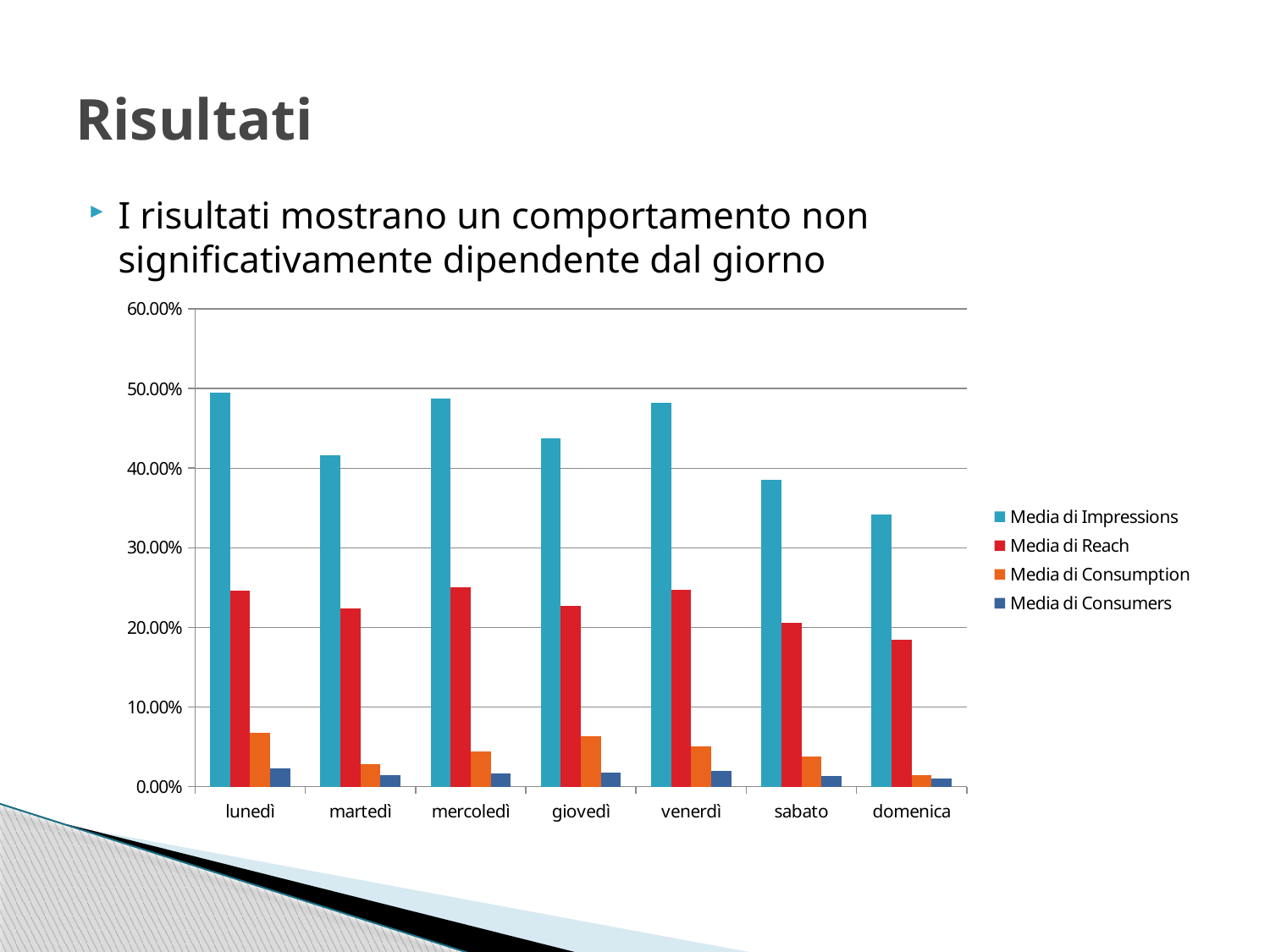
Is the value of Media di Impressions for sabato greater or less than 40.00%? less How many series does the chart's legend list? 4 What kind of chart is shown on the slide? bar chart Is the value of Media di Impressions for lunedì greater or less than 40.00%? greater Which colour represents Media di Reach in the chart? red Which day has the lowest value for Media di Consumption? domenica Which day has the lowest value for Media di Reach? domenica Which is larger, Media di Impressions for giovedì or for martedì? giovedì Which day has the lowest value for Media di Impressions? domenica Is the value of Media di Reach for lunedì greater or less than 20.00%? greater Which is larger, Media di Reach for lunedì or for domenica? lunedì How many days (categories) are shown on the x axis of the chart? 7